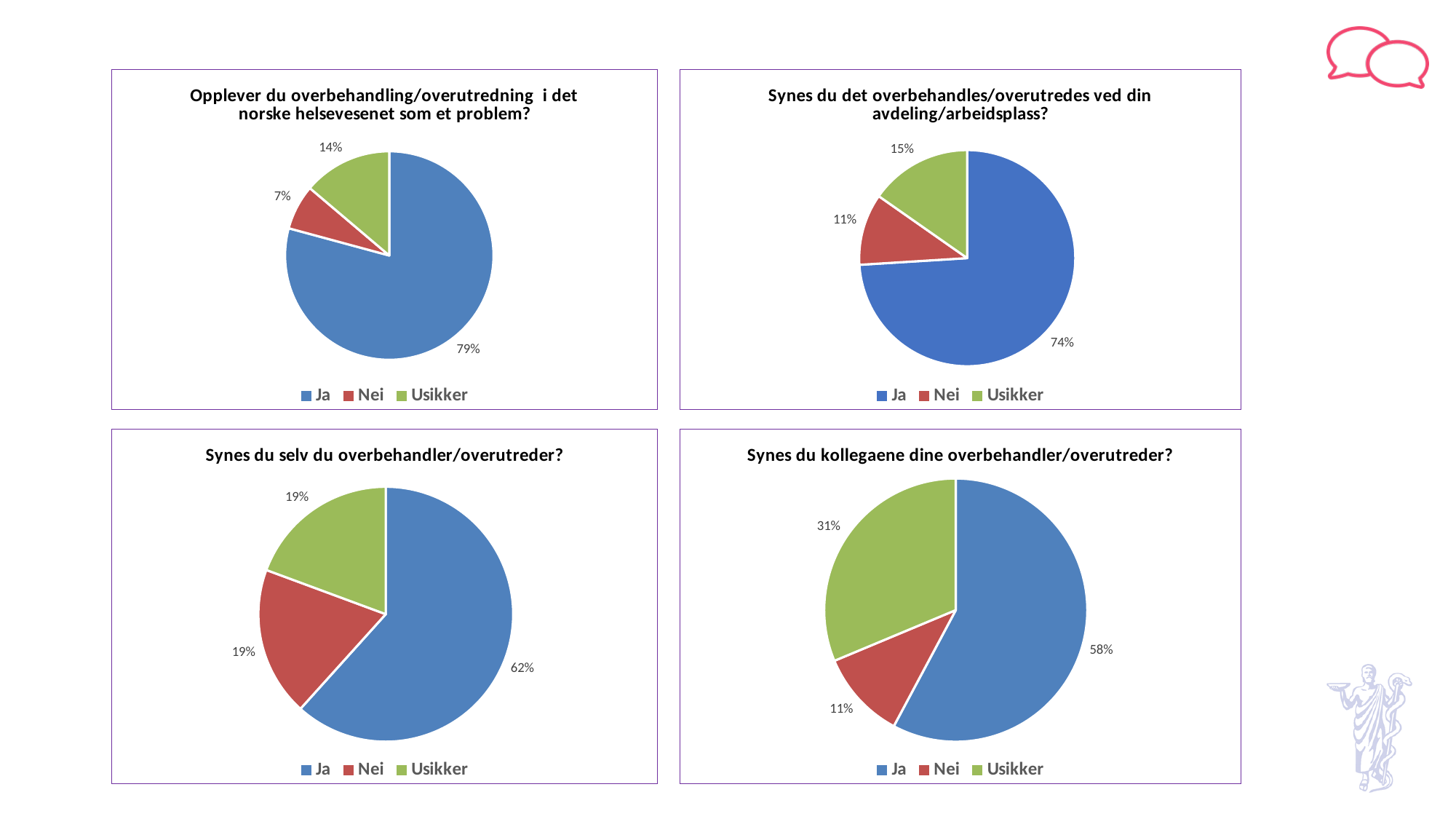
In the bottom-right chart 'Synes du kollegaene dine overbehandler/overutreder?', which answer has the smallest slice? Nei In the top-right chart 'Synes du det overbehandles/overutredes ved din avdeling/arbeidsplass?', which answer has the largest slice? Ja Is the Ja share larger in the top-left chart 'Opplever du overbehandling/overutredning i det norske helsevesenet som et problem?' or in the bottom-right chart 'Synes du kollegaene dine overbehandler/overutreder?'? Top-left chart In the bottom-left chart 'Synes du selv du overbehandler/overutreder?', what is the difference between the Ja share and the Nei share? 43% In the bottom-right chart 'Synes du kollegaene dine overbehandler/overutreder?', what colour is the Usikker slice? Green In the top-left chart 'Opplever du overbehandling/overutredning i det norske helsevesenet som et problem?', what share of respondents answered Ja? 79% In the top-left chart 'Opplever du overbehandling/overutredning i det norske helsevesenet som et problem?', what share answered Nei? 7% In the top-right chart 'Synes du det overbehandles/overutredes ved din avdeling/arbeidsplass?', what share answered Usikker? 15% How many entries does the legend of the top-right chart 'Synes du det overbehandles/overutredes ved din avdeling/arbeidsplass?' list? 3 In the bottom-right chart 'Synes du kollegaene dine overbehandler/overutreder?', what share answered Usikker? 31% In the bottom-left chart 'Synes du selv du overbehandler/overutreder?', what share answered Ja? 62% What type of chart is used in the bottom-left chart 'Synes du selv du overbehandler/overutreder?'? Pie chart